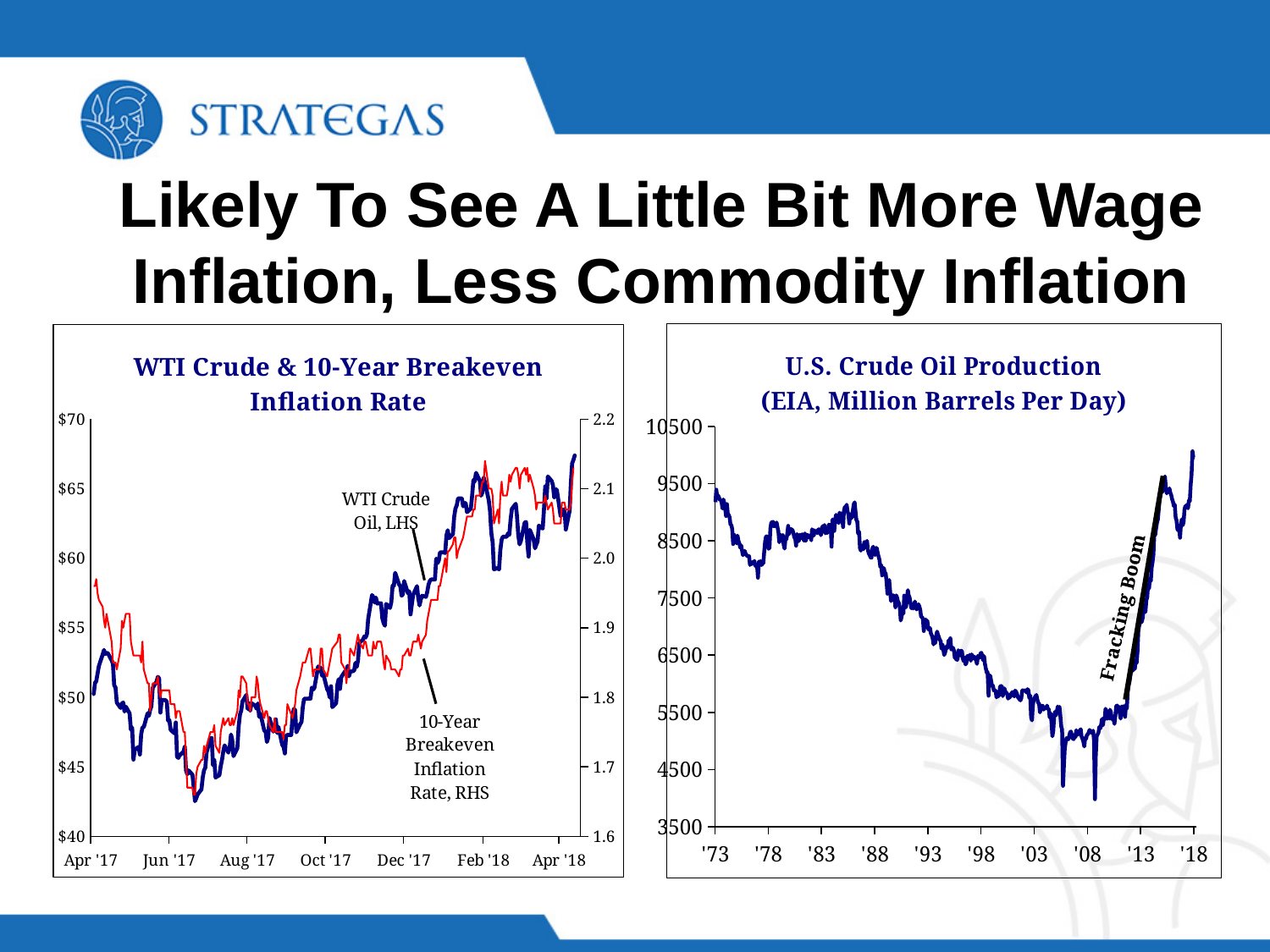
On the 'U.S. Crude Oil Production' chart, is the value at '73 greater or less than 8500? greater On the 'U.S. Crude Oil Production' chart, is the value at '18 greater or less than 9500? greater On the 'U.S. Crude Oil Production' chart, what does the annotation along the steep rise after 2010 say? Fracking Boom What kind of chart is the 'U.S. Crude Oil Production' chart on the right? Line chart On the 'WTI Crude & 10-Year Breakeven Inflation Rate' chart, is the WTI Crude Oil value at Apr '17 greater or less than $55? less How many series are plotted on the 'WTI Crude & 10-Year Breakeven Inflation Rate' chart? 2 On the 'WTI Crude & 10-Year Breakeven Inflation Rate' chart, which series is plotted on the right-hand axis (RHS)? 10-Year Breakeven Inflation Rate What kind of chart is the 'WTI Crude & 10-Year Breakeven Inflation Rate' chart on the left? Line chart On the 'U.S. Crude Oil Production' chart, which is larger: the value at '73 or the value at '08? '73 On the 'U.S. Crude Oil Production' chart, do values rise or fall between '88 and '08? fall